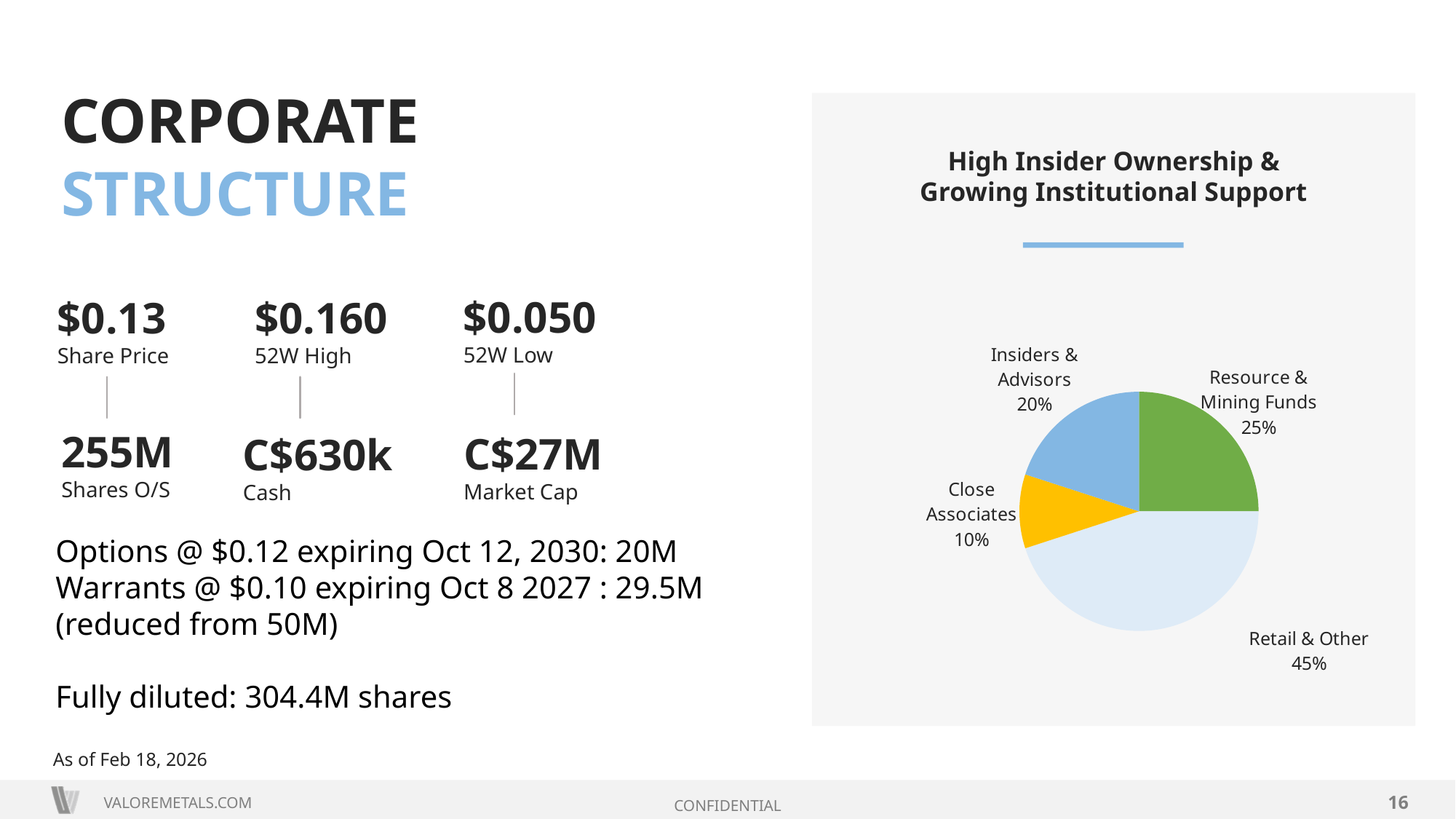
Which category has the largest slice of the pie? Retail & Other What share of ownership is held by Resource & Mining Funds? 25% Which is larger, the share for Insiders & Advisors or the share for Resource & Mining Funds? Resource & Mining Funds What colour is the Close Associates slice? yellow What is the title of the pie chart? High Insider Ownership & Growing Institutional Support Which category has the smallest slice of the pie? Close Associates How many categories are shown in the pie chart? 4 What is the difference in percentage points between Retail & Other and Resource & Mining Funds? 20 What share of ownership is held by Insiders & Advisors? 20% What share of ownership is held by Close Associates? 10% What kind of chart is shown on the slide? pie chart What share of ownership is held by Retail & Other? 45%